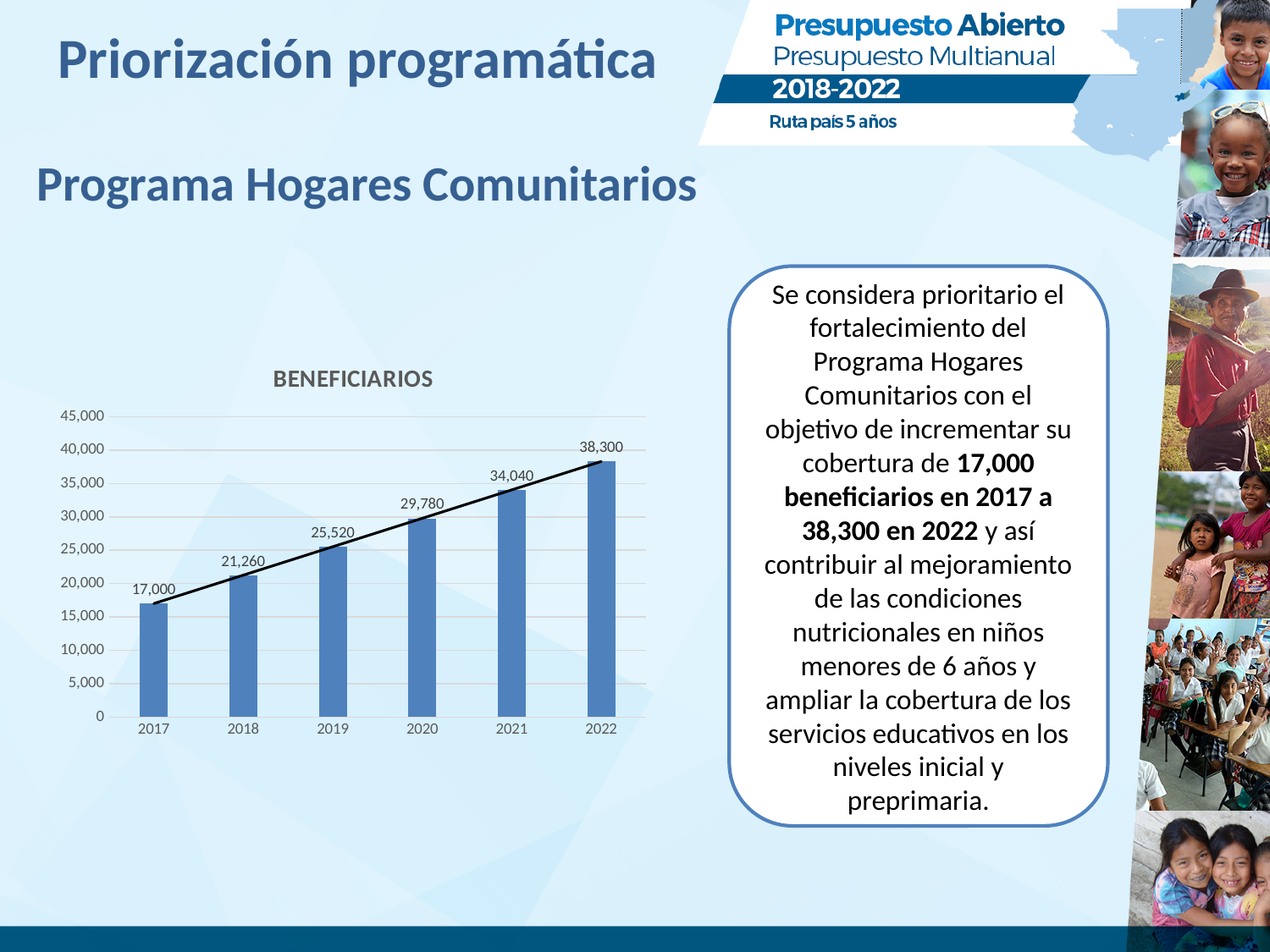
Which year has the highest value in the BENEFICIARIOS chart? 2022 Which year has the lowest value in the BENEFICIARIOS chart? 2017 What is the difference between the values for 2019 and 2018 in the BENEFICIARIOS chart? 4,260 What kind of chart is the BENEFICIARIOS chart? bar chart Do the values in the BENEFICIARIOS chart rise or fall from 2017 to 2022? rise What is the difference between the values for 2022 and 2017 in the BENEFICIARIOS chart? 21,300 What is the value for 2022 in the BENEFICIARIOS chart? 38,300 How many years are shown on the x axis of the BENEFICIARIOS chart? 6 What is the value for 2017 in the BENEFICIARIOS chart? 17,000 Which is larger in the BENEFICIARIOS chart, the value for 2021 or the value for 2019? 2021 What is the value for 2020 in the BENEFICIARIOS chart? 29,780 Is the value for 2020 in the BENEFICIARIOS chart greater or less than 25,000? greater